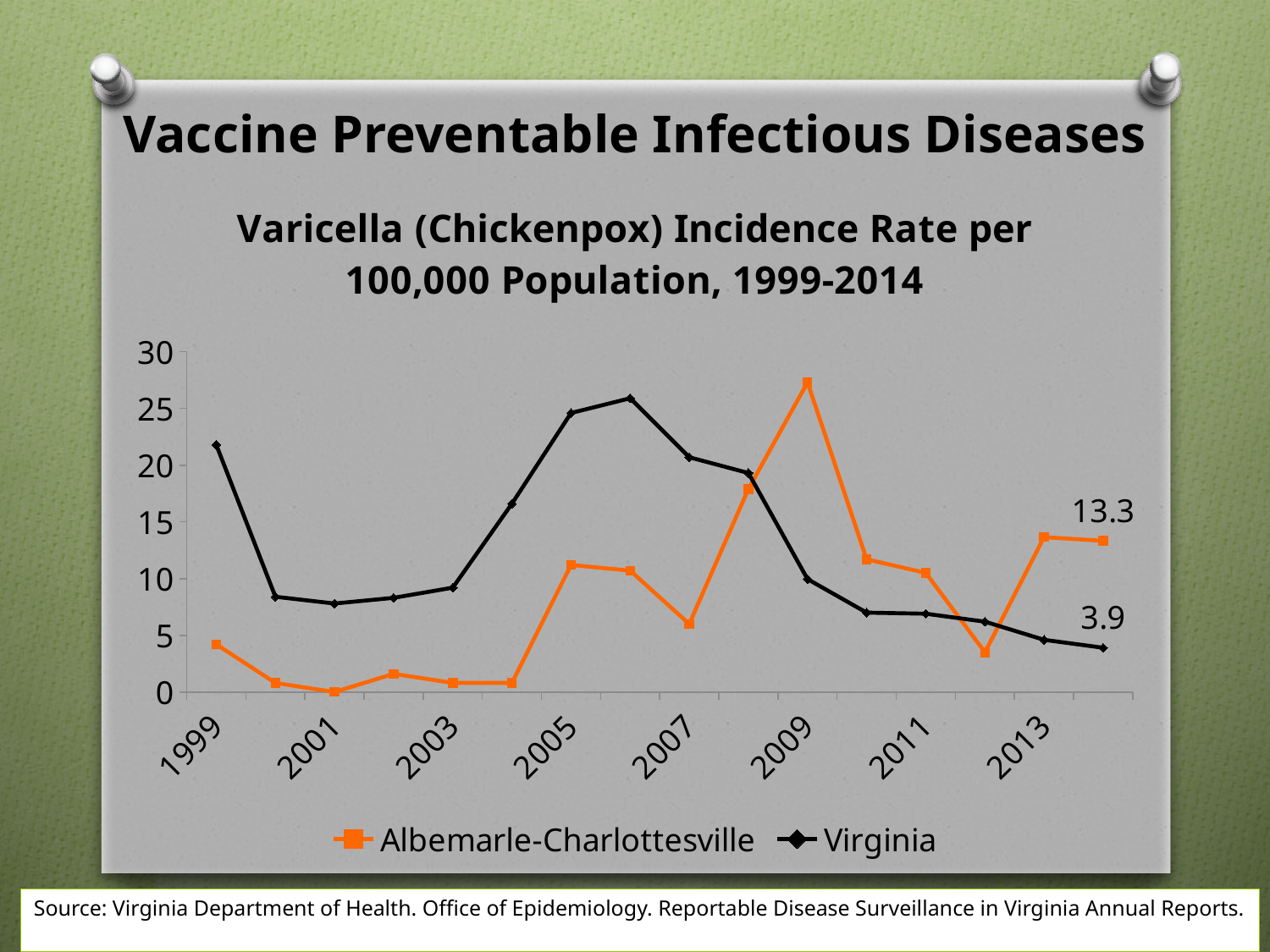
In 2014, which series has the higher incidence rate, Albemarle-Charlottesville or Virginia? Albemarle-Charlottesville Is the Albemarle-Charlottesville value for 2001 greater or less than 5? less Is the Albemarle-Charlottesville value for 2009 greater or less than 25? greater How many series does the legend list? 2 In which year does the Albemarle-Charlottesville series reach its highest value? 2009 What kind of chart is shown on the slide? Line chart What is the Virginia varicella incidence rate in 2014? 3.9 What is the Albemarle-Charlottesville varicella incidence rate in 2014? 13.3 What is the difference between the Albemarle-Charlottesville and Virginia rates in 2014? 9.4 Does the Virginia series rise or fall from 2009 to 2014? Fall How many years of data are plotted for each series? 16 Is the Virginia value for 1999 greater or less than 20? greater